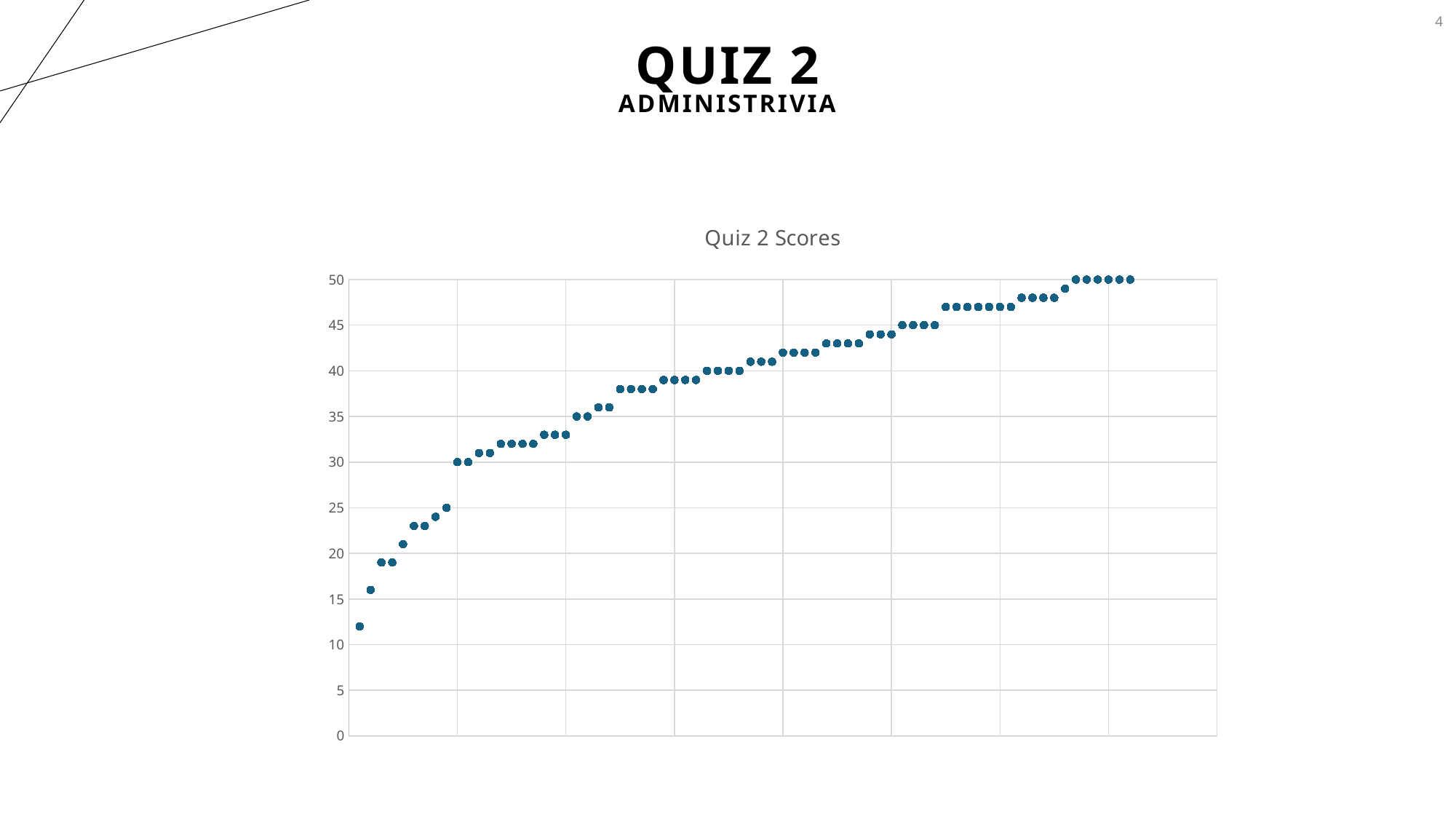
What is the title of the chart? Quiz 2 Scores Are the highest plotted scores greater or less than 45? greater What kind of chart is shown on the slide? Scatter chart Is the lowest plotted score greater or less than 10? greater Is the rightmost point in the chart greater or less than 40? greater What is the highest value shown on the y axis? 50 Do the plotted scores rise or fall from left to right along the x axis? Rise What is the highest score plotted in the Quiz 2 Scores chart? 50